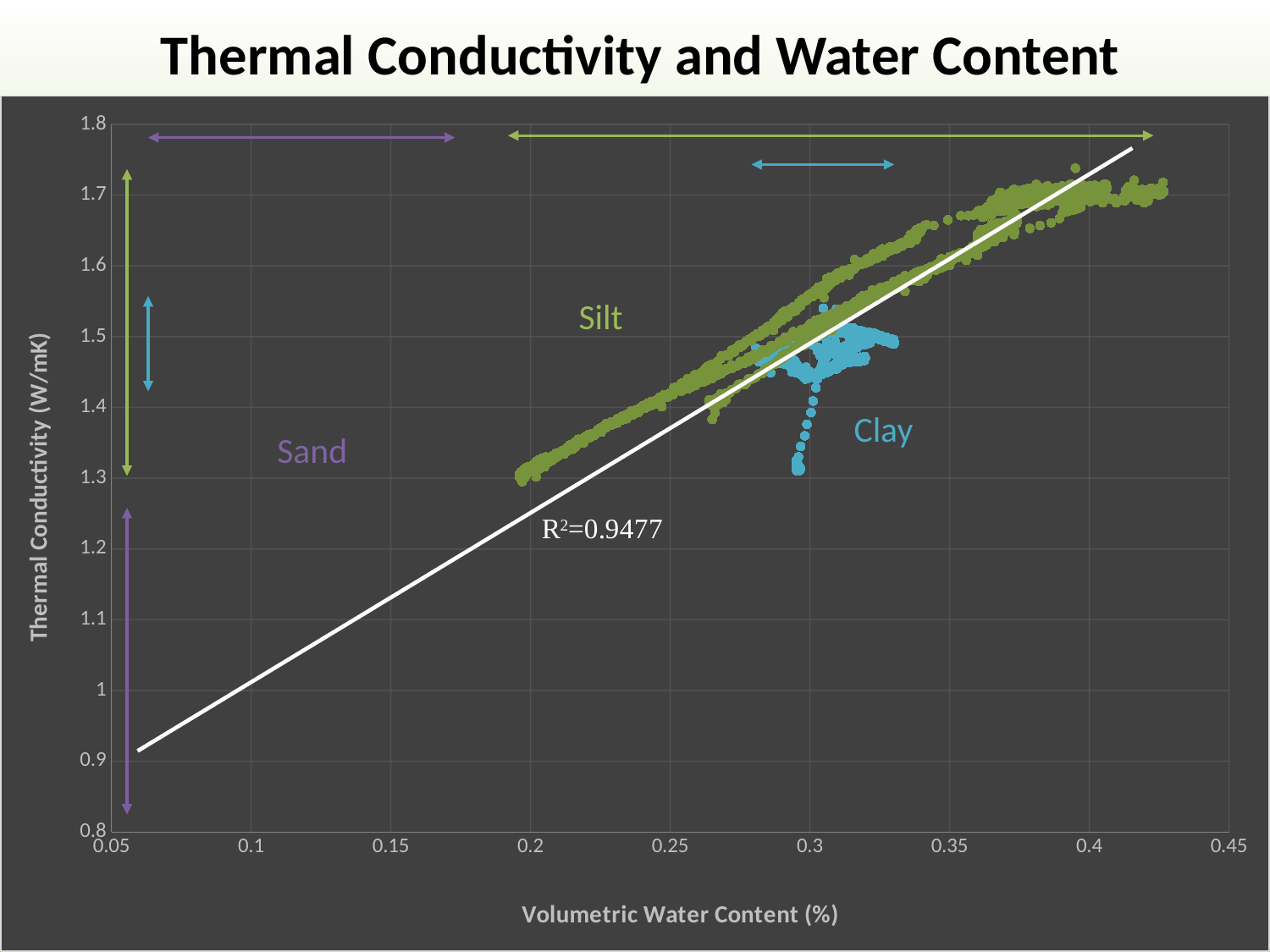
What is the title of the chart? Thermal Conductivity and Water Content Which soil type reaches the higher thermal conductivity, Silt or Clay? Silt How many soil types are labelled on the chart? 3 What is the minimum value shown on the y axis? 0.8 Is the highest thermal conductivity of the Clay points greater or less than 1.6 W/mK? less What is the maximum value shown on the x axis? 0.45 What is the label of the y axis? Thermal Conductivity (W/mK) Is the lowest thermal conductivity of the Silt points greater or less than 1.4 W/mK? less What is the R² value printed next to the trend line? R²=0.9477 Does the thermal conductivity of the Silt data rise or fall as volumetric water content increases? rise Is the highest thermal conductivity of the Silt points greater or less than 1.6 W/mK? greater What kind of chart is shown on the slide? scatter chart